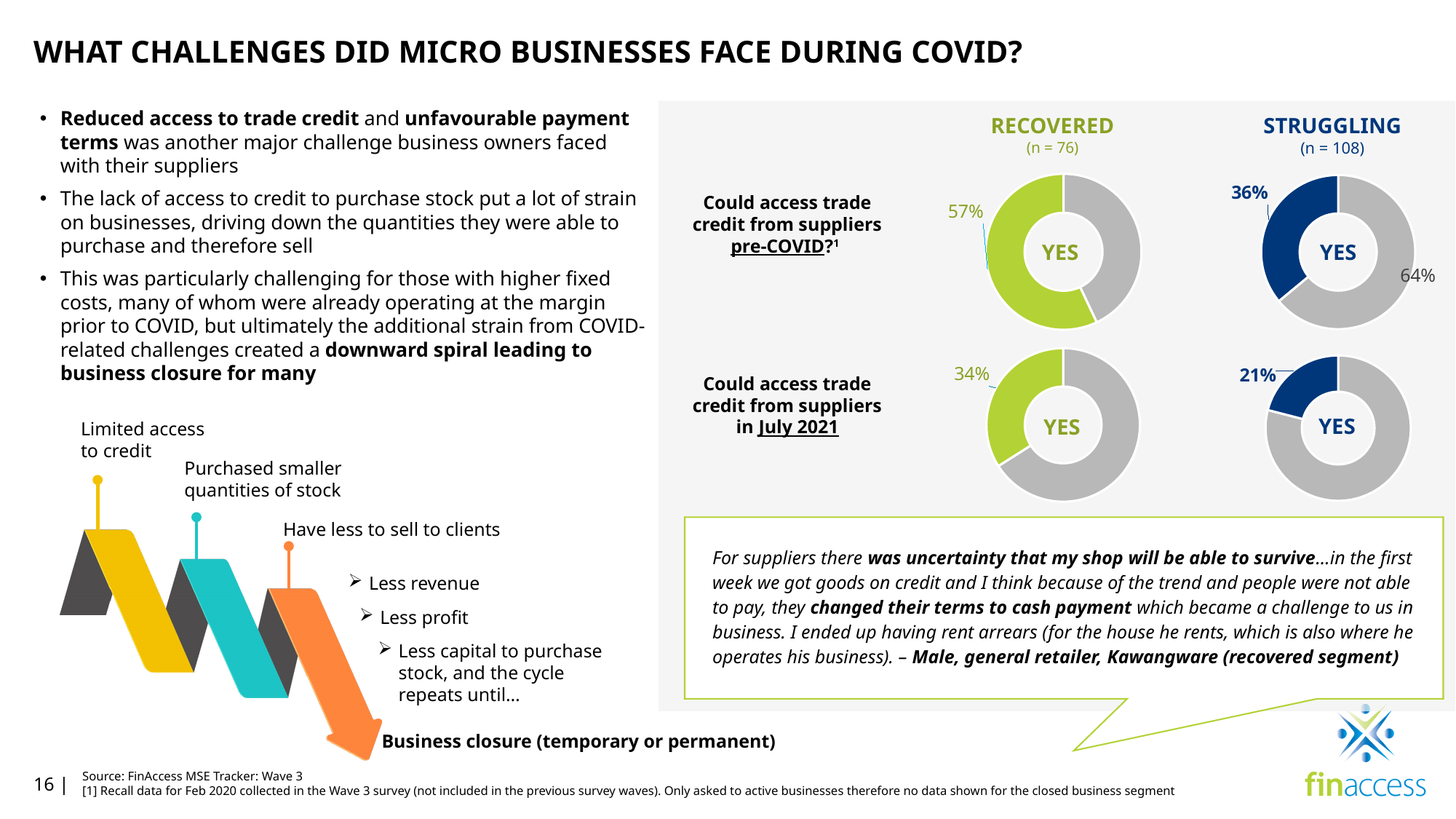
In the 'Struggling' donut chart for 'Could access trade credit from suppliers pre-COVID', what percentage answered YES? 36% What is the difference in YES share between the Recovered and Struggling segments in the pre-COVID trade credit donut charts? 21 percentage points What is the sample size (n) shown for the Struggling segment in the donut charts? n = 108 In the 'Recovered' donut chart for 'Could access trade credit from suppliers pre-COVID', what percentage answered YES? 57% For the pre-COVID trade credit donut charts, which segment has the higher YES share, Recovered or Struggling? Recovered In the 'Struggling' donut chart for 'Could access trade credit from suppliers in July 2021', what percentage answered YES? 21% What is the difference in YES share between the Recovered and Struggling segments in the July 2021 trade credit donut charts? 13 percentage points Across the four donut charts, which chart shows the lowest YES share? Struggling, July 2021 (21%) In the 'Recovered' donut chart for 'Could access trade credit from suppliers in July 2021', what percentage answered YES? 34% What type of chart is used to show the share of businesses that could access trade credit from suppliers? Donut (pie) chart For the Recovered segment, by how many percentage points did the YES share for accessing trade credit fall from pre-COVID to July 2021? 23 percentage points In the 'Struggling' pre-COVID donut chart, what percentage is shown for the grey (non-YES) portion? 64%